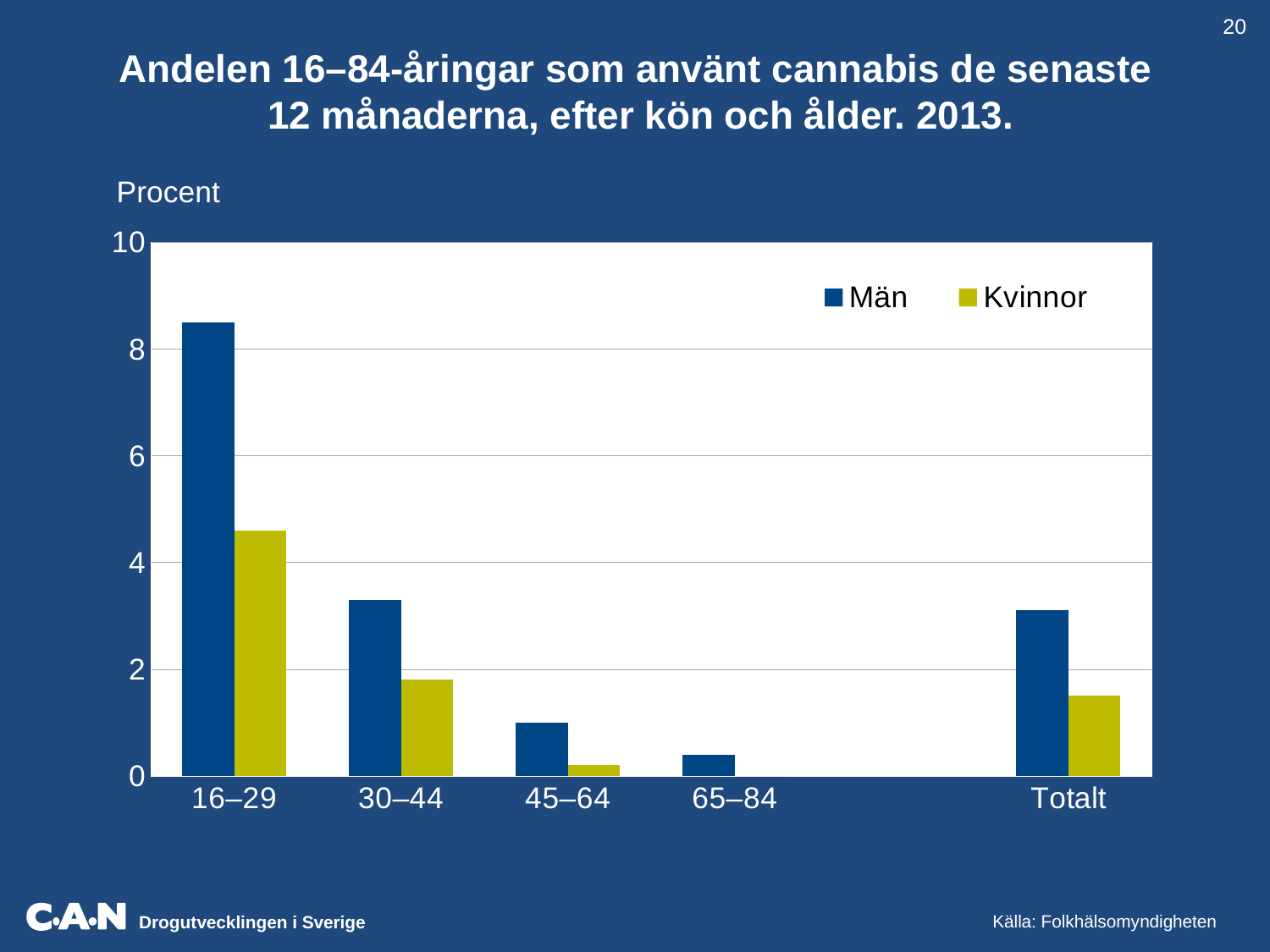
What kind of chart is shown on the slide? bar chart How many series does the legend list? 2 Is the value for Kvinnor in the 16–29 group greater or less than 4? greater Which is larger in the 30–44 group, Män or Kvinnor? Män Which age group has the highest value for Kvinnor? 16–29 Which age group has the lowest value for Män? 65–84 Is the value for Män in the 16–29 group greater or less than 8? greater Do the values for Män rise or fall across the age groups from 16–29 to 65–84? fall What unit is shown on the y axis label? Procent Is the value for Män in the Totalt category greater or less than 2? greater How many age categories (including Totalt) are shown on the x axis? 5 Which age group has the highest value for Män? 16–29